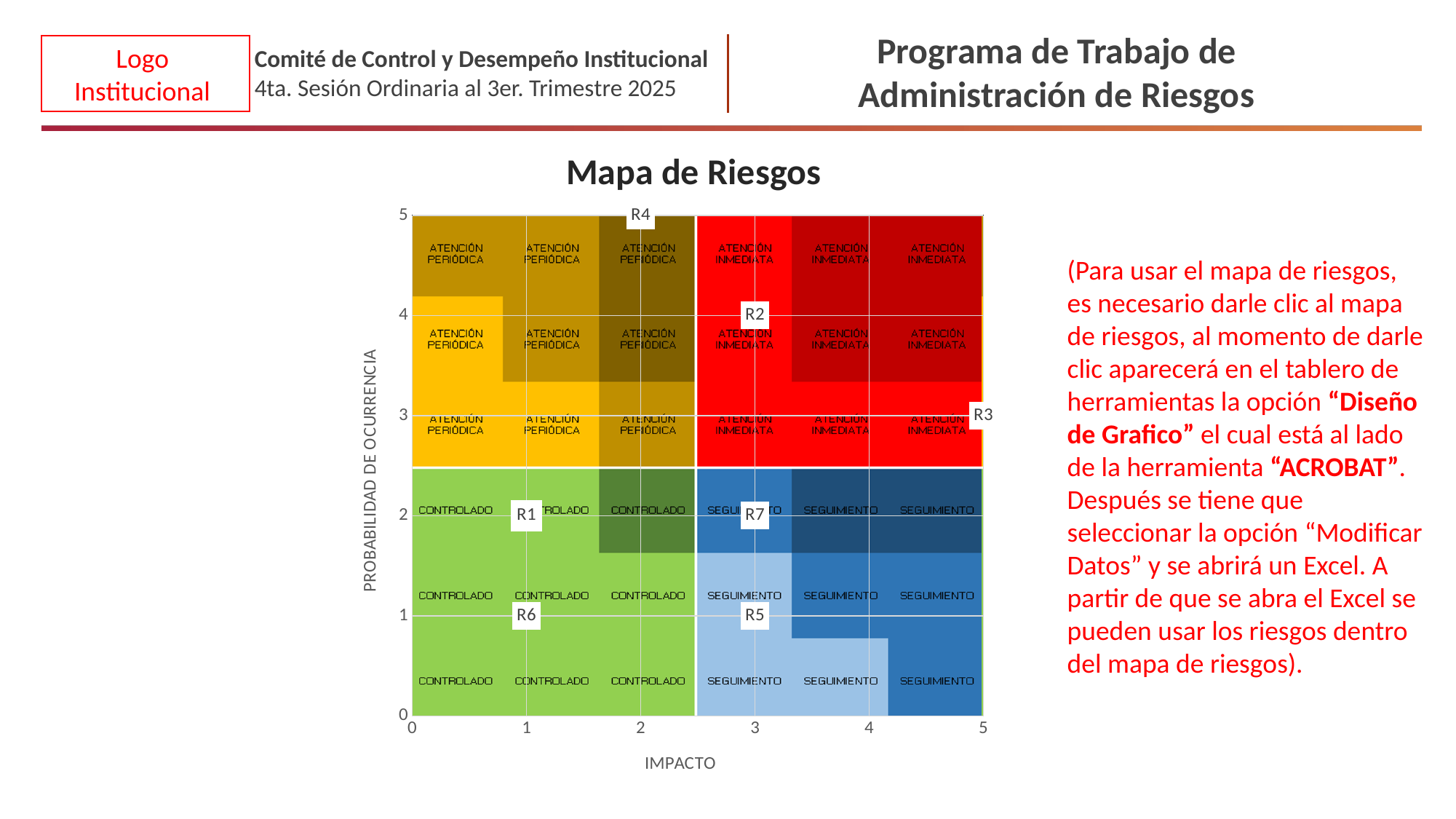
How many risk points (R labels) are plotted on the Mapa de Riesgos? 7 What is the difference between the probability of occurrence of R4 and that of R6 on the Mapa de Riesgos? 4 What is the title of the chart on the slide? Mapa de Riesgos Which has a higher probability of occurrence on the Mapa de Riesgos, R2 or R7? R2 What is the probability of occurrence value for R4 on the Mapa de Riesgos? 5 What is the label of the horizontal axis of the Mapa de Riesgos? IMPACTO Which risk has the highest probability of occurrence on the Mapa de Riesgos? R4 What is the probability of occurrence value for R2 on the Mapa de Riesgos? 4 What kind of chart is the Mapa de Riesgos? scatter chart What is the impact value for R1 on the Mapa de Riesgos? 1 Which risk has the highest impact on the Mapa de Riesgos? R3 What is the impact value for R3 on the Mapa de Riesgos? 5